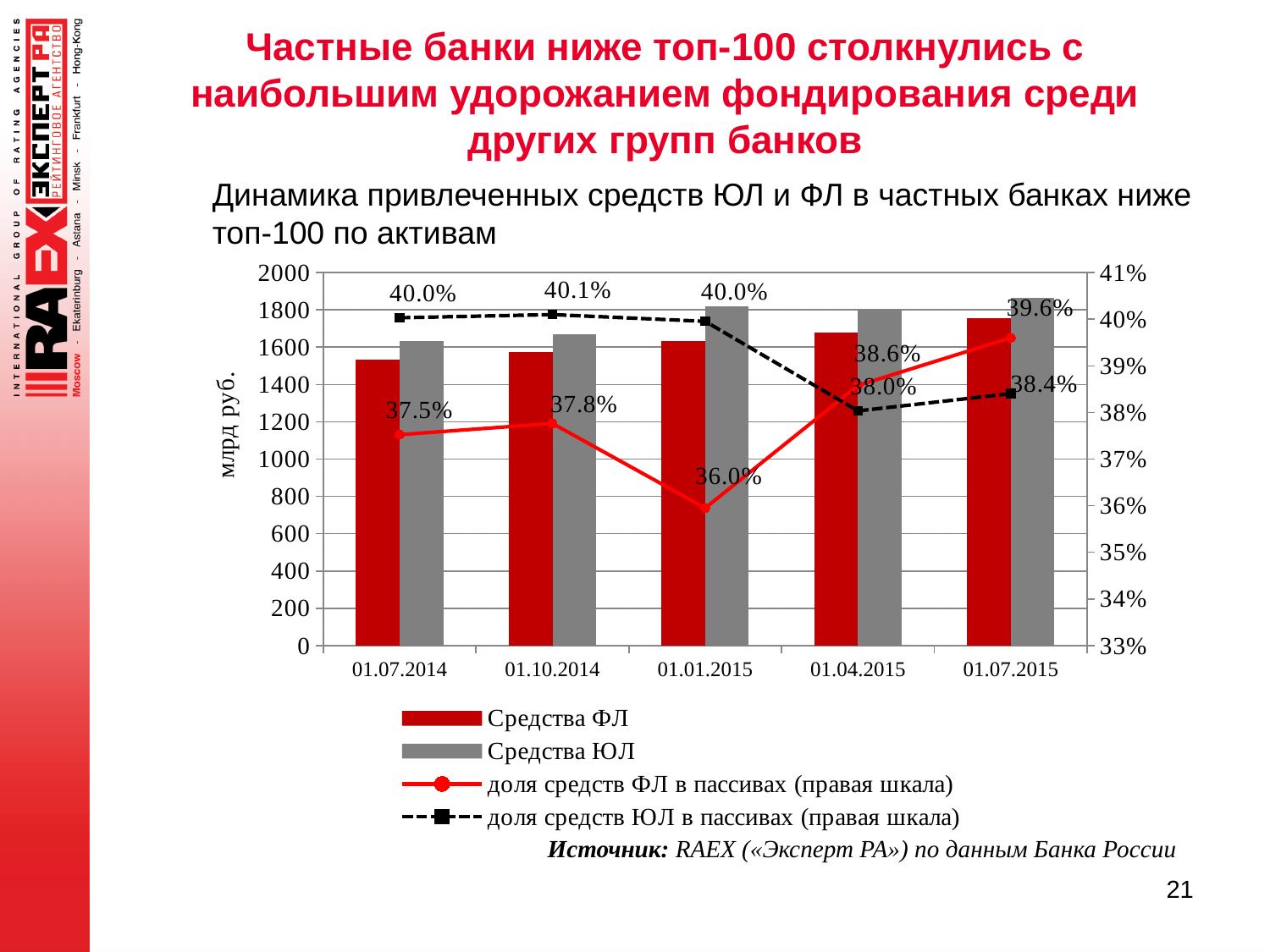
What is the value of доля средств ФЛ в пассивах (правая шкала) at 01.01.2015? 36.0% What is the value of доля средств ЮЛ в пассивах (правая шкала) at 01.10.2014? 40.1% At which date is доля средств ЮЛ в пассивах (правая шкала) highest? 01.10.2014 Does доля средств ЮЛ в пассивах (правая шкала) rise or fall from 01.01.2015 to 01.07.2015? fall At 01.07.2015, which is larger: доля средств ФЛ в пассивах or доля средств ЮЛ в пассивах? доля средств ФЛ в пассивах What is the value of доля средств ФЛ в пассивах (правая шкала) at 01.07.2015? 39.6% How many series does the chart legend list? 4 At which date is доля средств ФЛ в пассивах (правая шкала) lowest? 01.01.2015 Is the value of Средства ФЛ at 01.07.2014 greater or less than 1600? less How many dates are shown on the x axis of the chart? 5 What is the difference between доля средств ЮЛ в пассивах and доля средств ФЛ в пассивах at 01.01.2015? 4.0% Is the value of Средства ЮЛ at 01.01.2015 greater or less than 1600? greater